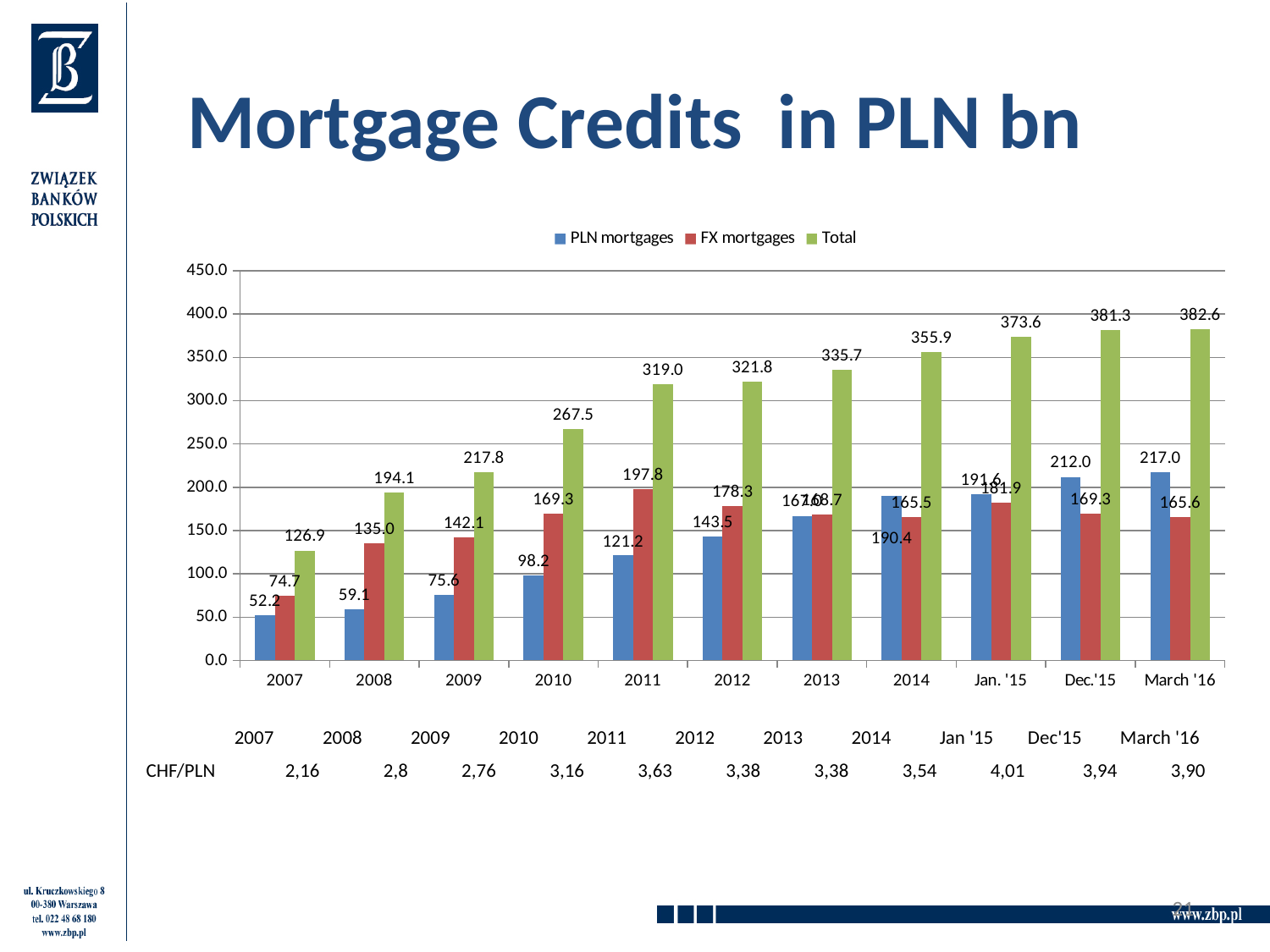
In which period is the Total highest? March '16 Is the Total value for 2009 greater or less than 200? greater In which year are PLN mortgages lowest? 2007 Does the Total series rise or fall from 2007 to March '16? rise In 2012, which is larger: PLN mortgages or FX mortgages? FX mortgages What is the value of FX mortgages in 2011? 197.8 What is the difference between PLN mortgages and FX mortgages in 2014? 24.9 What is the Total value for 2010? 267.5 In which period are FX mortgages highest? 2011 How many series does the legend list? 3 What is the value of PLN mortgages for March '16? 217.0 How many periods are shown on the x axis of the chart? 11